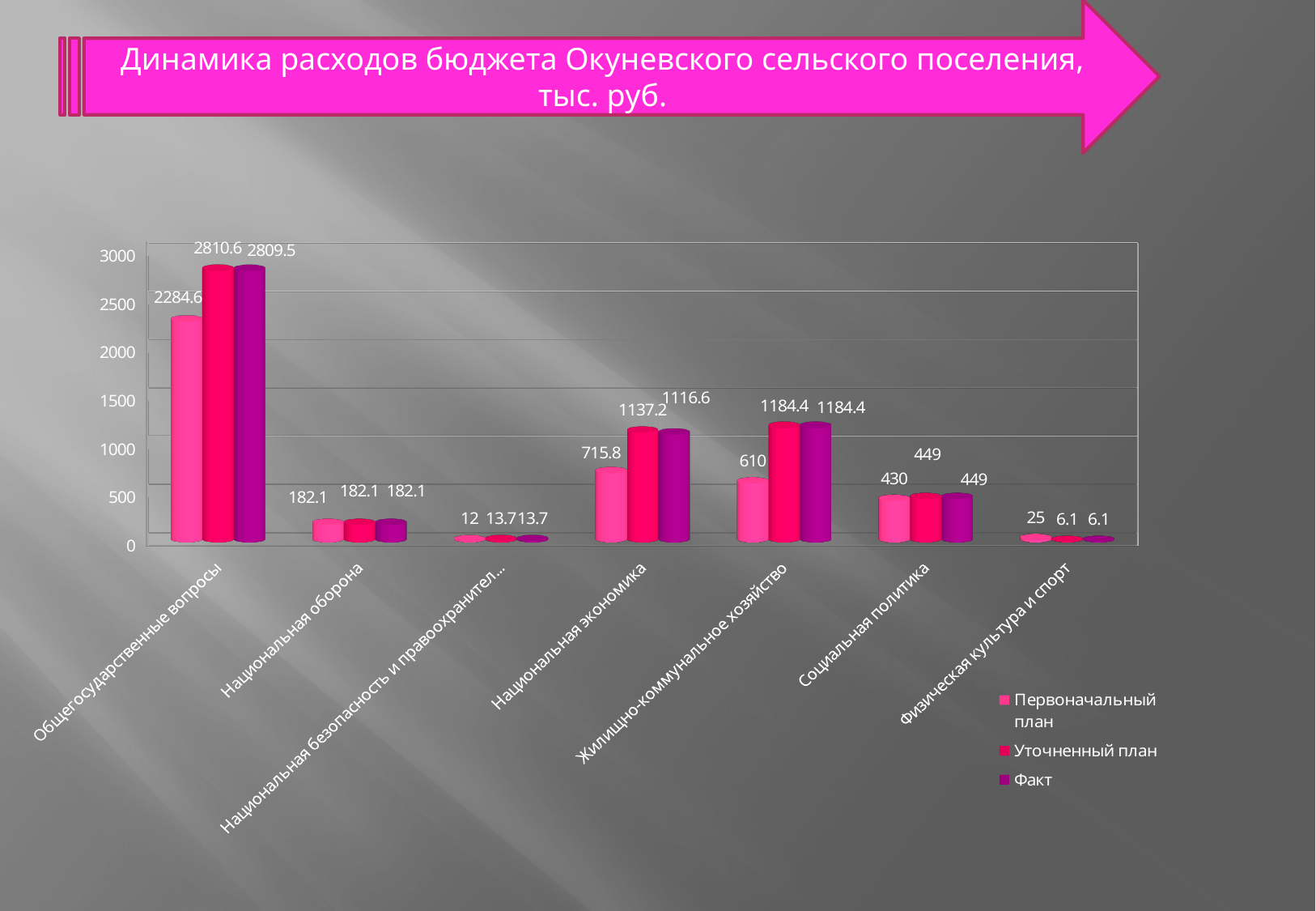
What is the value of Первоначальный план for Общегосударственные вопросы? 2284.6 What is the value of Уточненный план for Национальная экономика? 1137.2 Which is larger for Социальная политика: Первоначальный план or Факт? Факт What is the value of Факт for Жилищно-коммунальное хозяйство? 1184.4 What kind of chart is shown on the slide? bar chart What is the value of Первоначальный план for Физическая культура и спорт? 25 How many categories are shown on the x axis? 7 Which category has the lowest Уточненный план value? Физическая культура и спорт How many series does the legend list? 3 Is the Первоначальный план value for Национальная экономика greater or less than 1000? less Which category has the highest Факт value? Общегосударственные вопросы What is the difference between Уточненный план and Первоначальный план for Жилищно-коммунальное хозяйство? 574.4